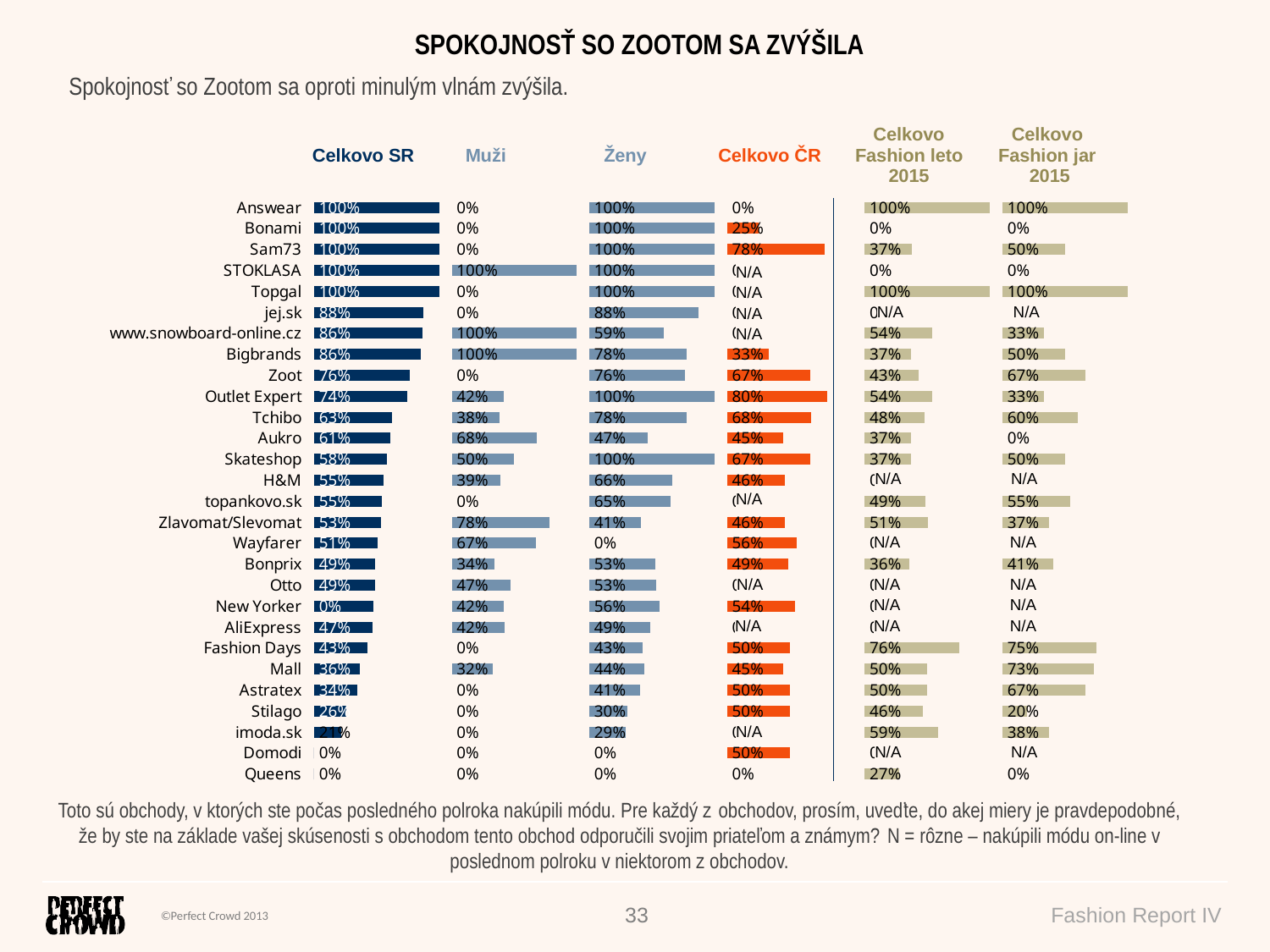
In the Celkovo SR chart, what is the difference between Zoot and Tchibo? 13 percentage points In the Celkovo ČR chart, what is the value for Outlet Expert? 80% In the Celkovo SR chart, what is the value for Zoot? 76% In the Celkovo Fashion leto 2015 chart, what is the value for Fashion Days? 76% In the Muži chart, which is larger, Aukro or Tchibo? Aukro What type of chart is used for the Celkovo SR column? Bar chart In the Muži chart, what is the value for Zlavomat/Slevomat? 78% How many stores are listed in the Celkovo SR chart? 28 In the Celkovo ČR chart, which store has the highest value? Outlet Expert In the Celkovo Fashion jar 2015 chart, which is larger, Zoot or Skateshop? Zoot In the Celkovo Fashion jar 2015 chart, what is the value for Mall? 73% In the Ženy chart, what is the value for Tchibo? 78%